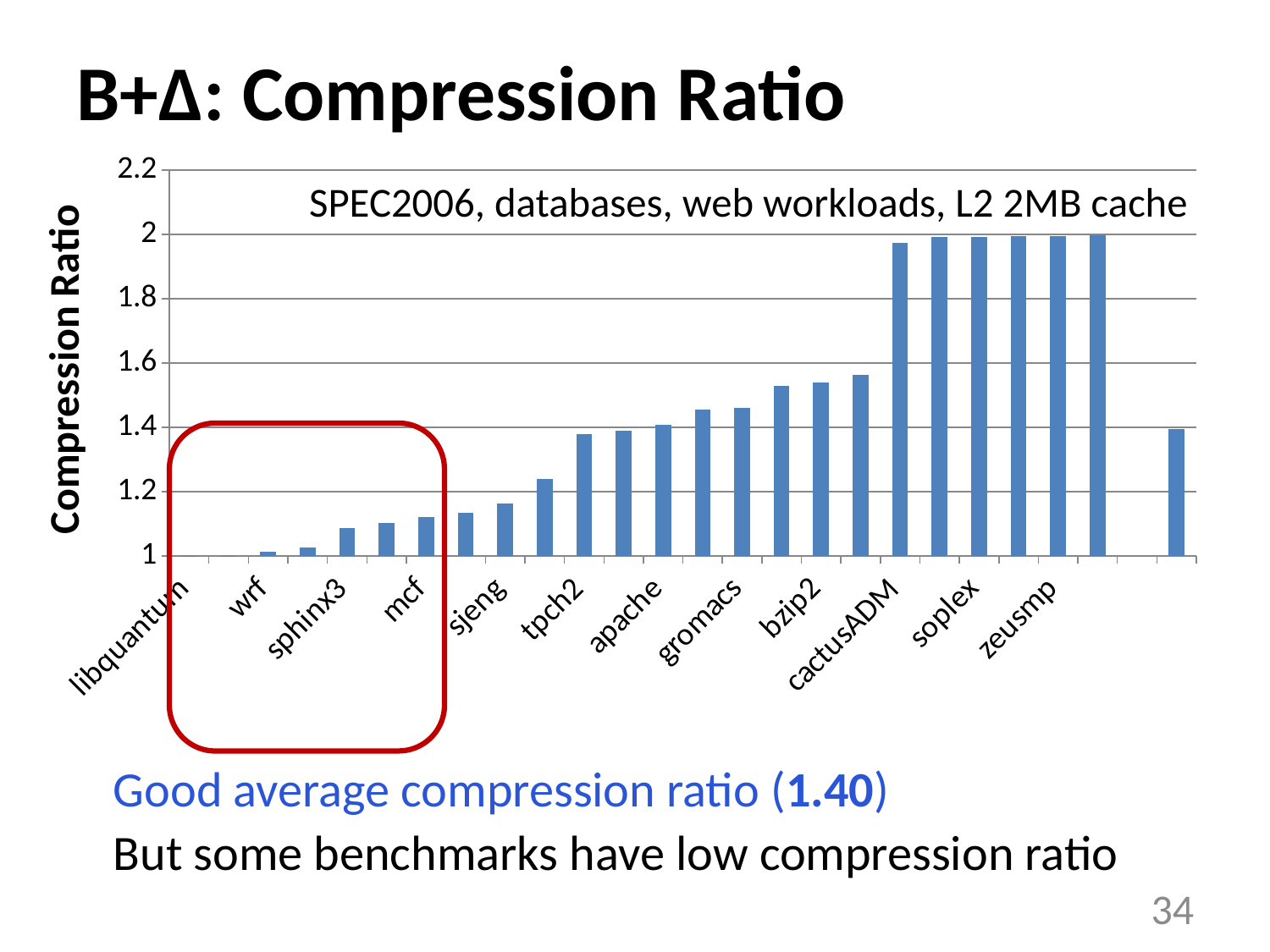
Is the compression ratio for cactusADM greater or less than 1.8? greater What is the title of the y axis? Compression Ratio Which labeled benchmark has the lowest compression ratio? libquantum Do the compression ratios generally rise or fall from left to right across the benchmarks? rise Is the compression ratio for gromacs greater or less than 1.4? greater Is the compression ratio for soplex greater or less than 1.8? greater What text is printed inside the plot area describing the workloads? SPEC2006, databases, web workloads, L2 2MB cache Which has the higher compression ratio, sjeng or zeusmp? zeusmp What kind of chart is shown on the slide? bar chart Which has the higher compression ratio, bzip2 or sphinx3? bzip2